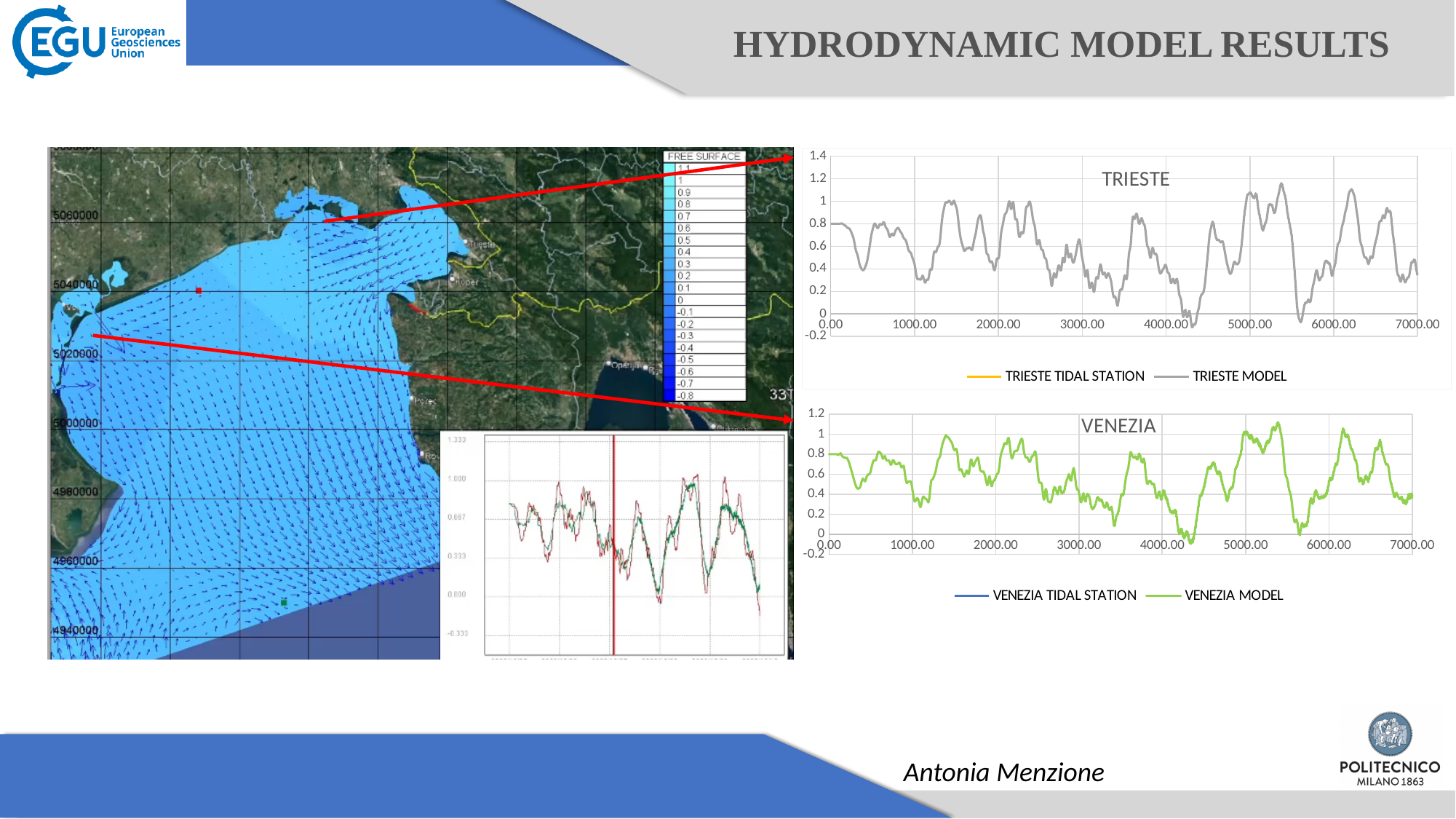
What kind of chart is the VENEZIA chart? line chart In the TRIESTE chart, what colour is the TRIESTE MODEL line? grey How many series does the legend of the VENEZIA chart list? 2 In the TRIESTE chart, is the peak of the TRIESTE MODEL line between 5000.00 and 6000.00 greater or less than 1? greater In the TRIESTE chart, does the TRIESTE MODEL line rise or fall between 4000.00 and its lowest point just after 4000.00? fall How many series does the legend of the TRIESTE chart list? 2 In the VENEZIA chart, is the lowest value of the VENEZIA MODEL line greater or less than 0.2? less In the VENEZIA chart, is the value of the VENEZIA MODEL line at 7000.00 greater or less than 0.8? less In the VENEZIA chart, what are the two legend entries? VENEZIA TIDAL STATION and VENEZIA MODEL In the VENEZIA chart, does the VENEZIA MODEL line rise or fall between 4300.00 and 5000.00? rise What kind of chart is the TRIESTE chart? line chart